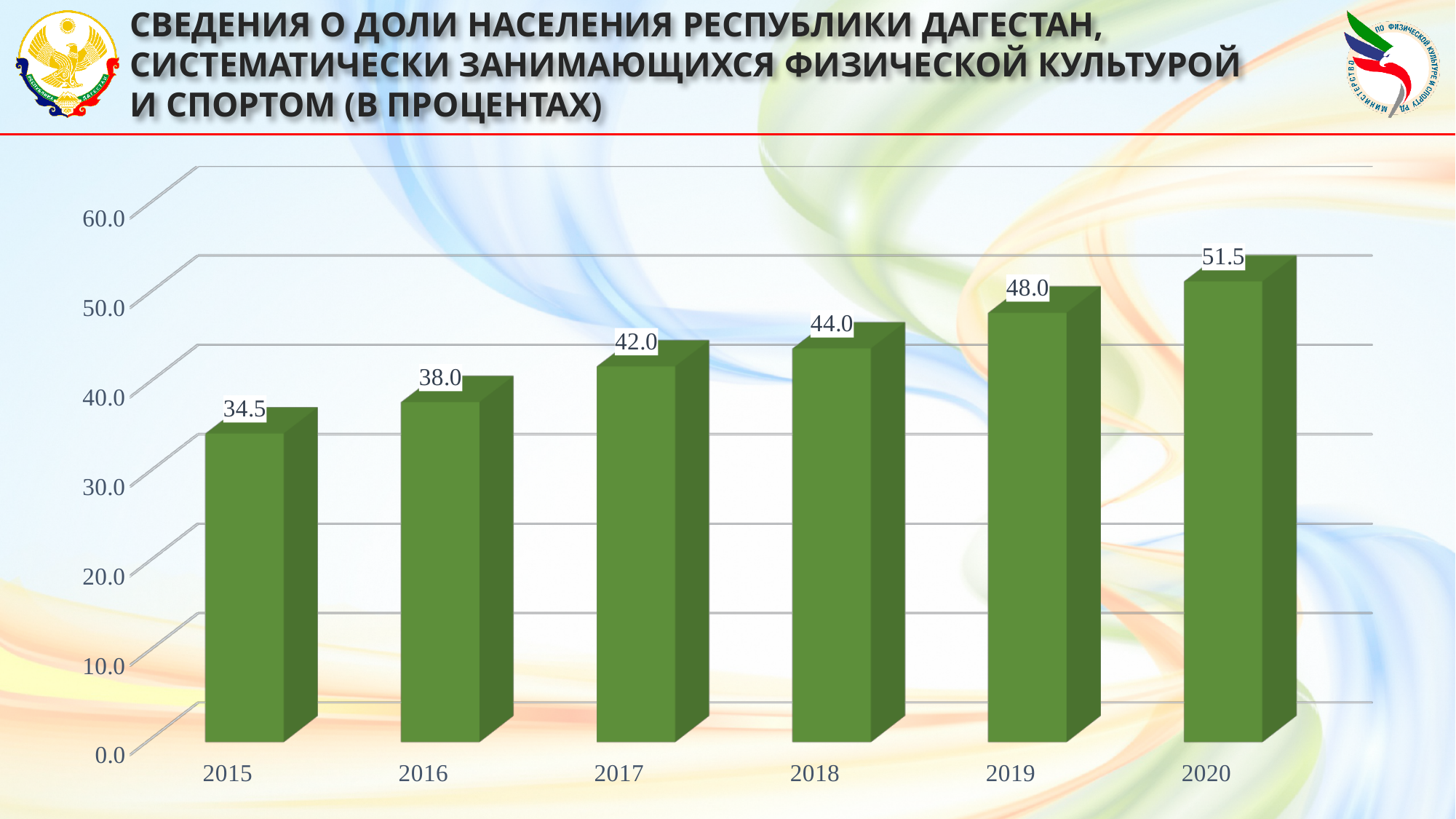
Which year has the highest value? 2020 What is the value for 2020? 51.5 What is the value for 2018? 44.0 What is the value for 2015? 34.5 What is the difference between the values for 2019 and 2018? 4.0 How many years are shown on the x axis? 6 What is the difference between the values for 2020 and 2015? 17.0 Which is larger, the value for 2017 or the value for 2016? 2017 Which year has the lowest value? 2015 Is the value for 2019 greater or less than 40.0? greater What kind of chart is shown on the slide? bar chart Do the values rise or fall from 2015 to 2020? rise